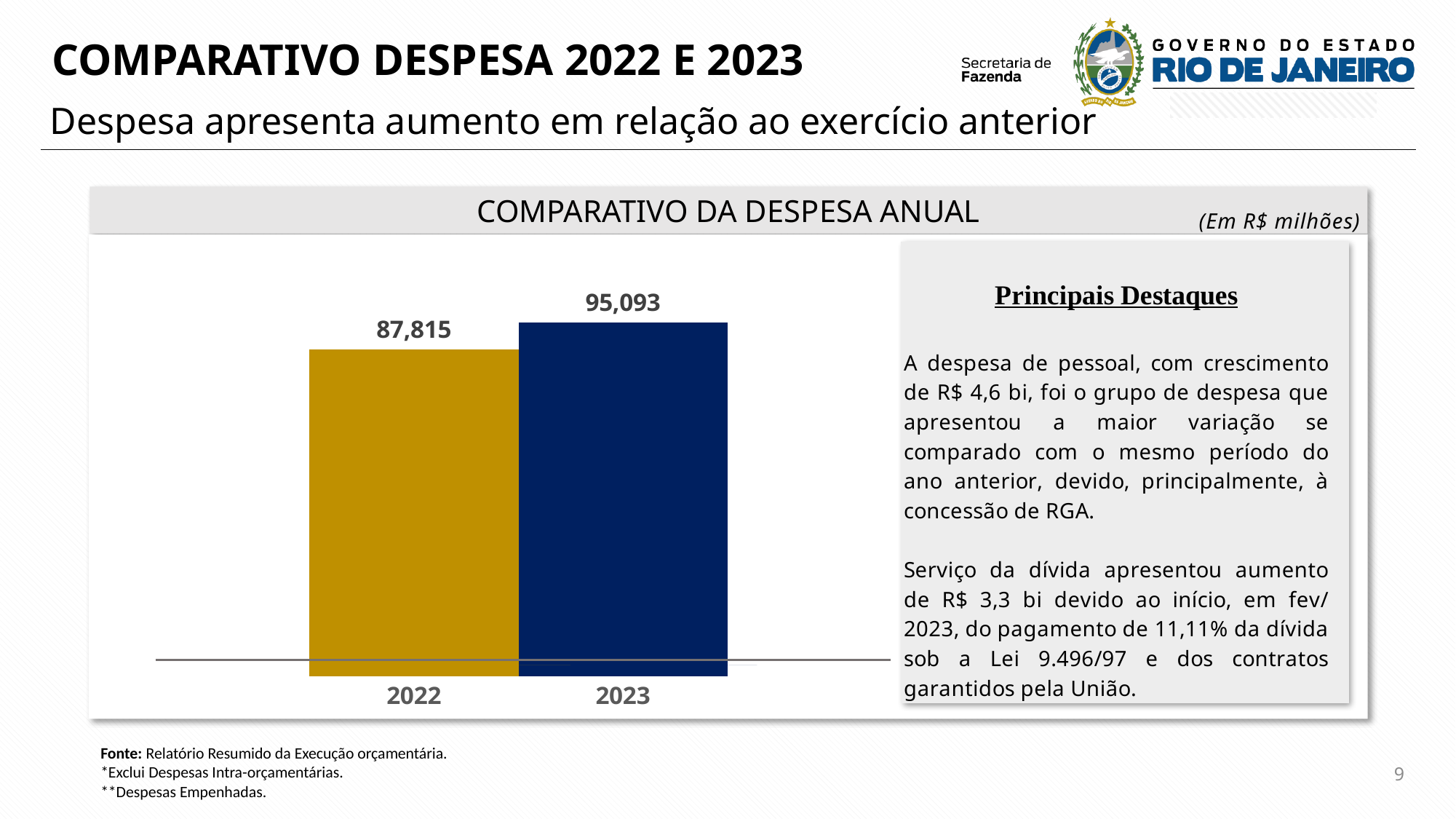
Do the values rise or fall from 2022 to 2023? Rise What kind of chart is shown on the slide? Bar chart What is the title of the chart? COMPARATIVO DA DESPESA ANUAL Which year has the higher expense value? 2023 What is the value for 2023 in the chart? 95,093 Which year has the lower expense value? 2022 What is the value for 2022 in the chart? 87,815 In what unit are the chart values expressed? R$ milhões Is the value for 2023 larger than the value for 2022? Yes What is the difference between the 2023 and 2022 values? 7,278 How many years are shown in the chart? 2